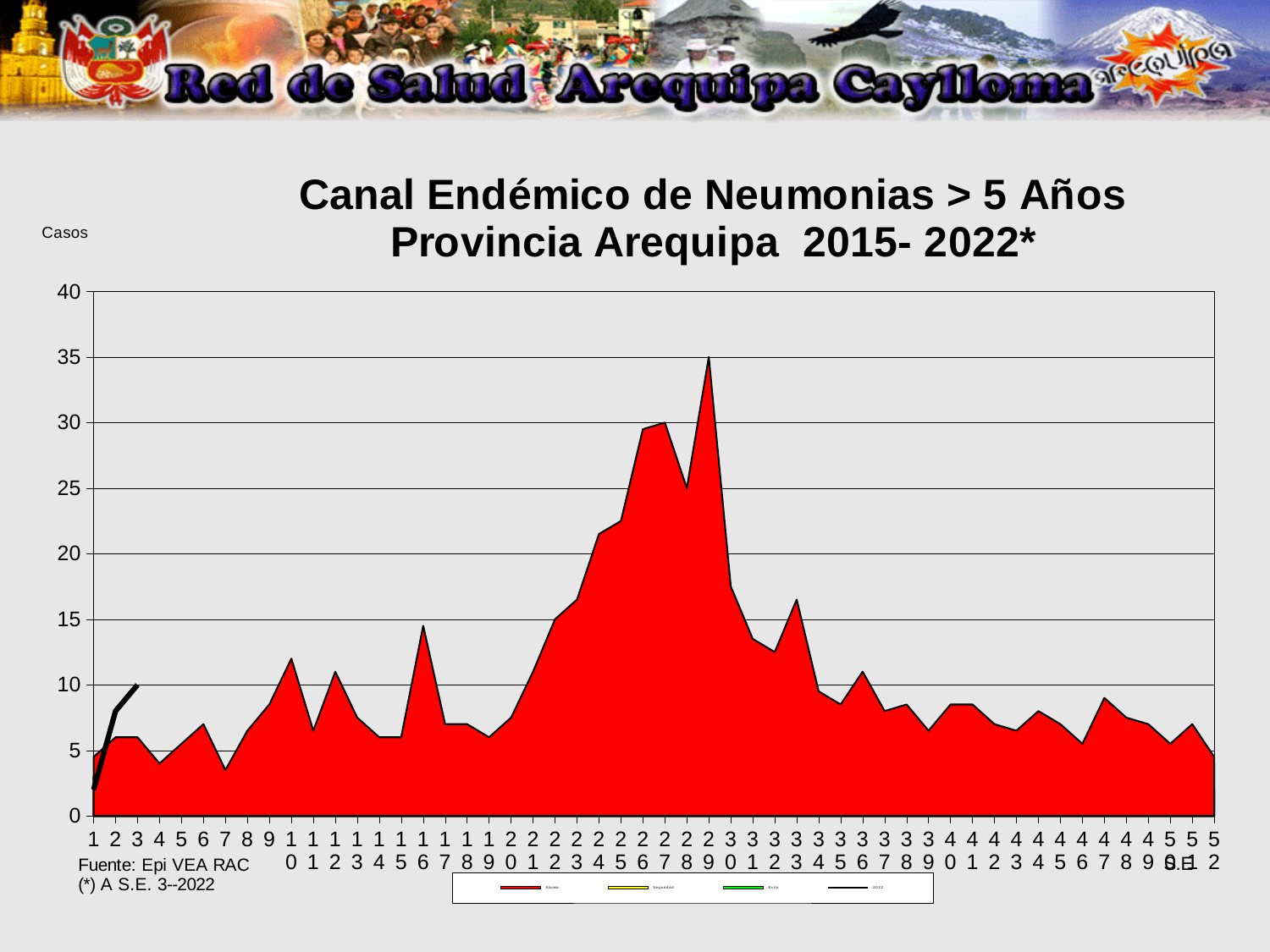
Is the value of the red area at week 26 greater or less than 25? greater Which week has the highest value of the red area? 29 Which has the larger value of the red area, week 29 or week 33? week 29 What kind of chart is shown on the slide? area chart Is the value of the red area at week 40 greater or less than 10? less What is the title of the chart? Canal Endémico de Neumonias > 5 Años Provincia Arequipa 2015- 2022* Between week 20 and week 29, do the values of the red area generally rise or fall? rise What label is shown on the vertical axis of the chart? Casos Is the value of the red area at week 1 greater or less than 10? less How many weeks are shown along the x axis of the chart? 52